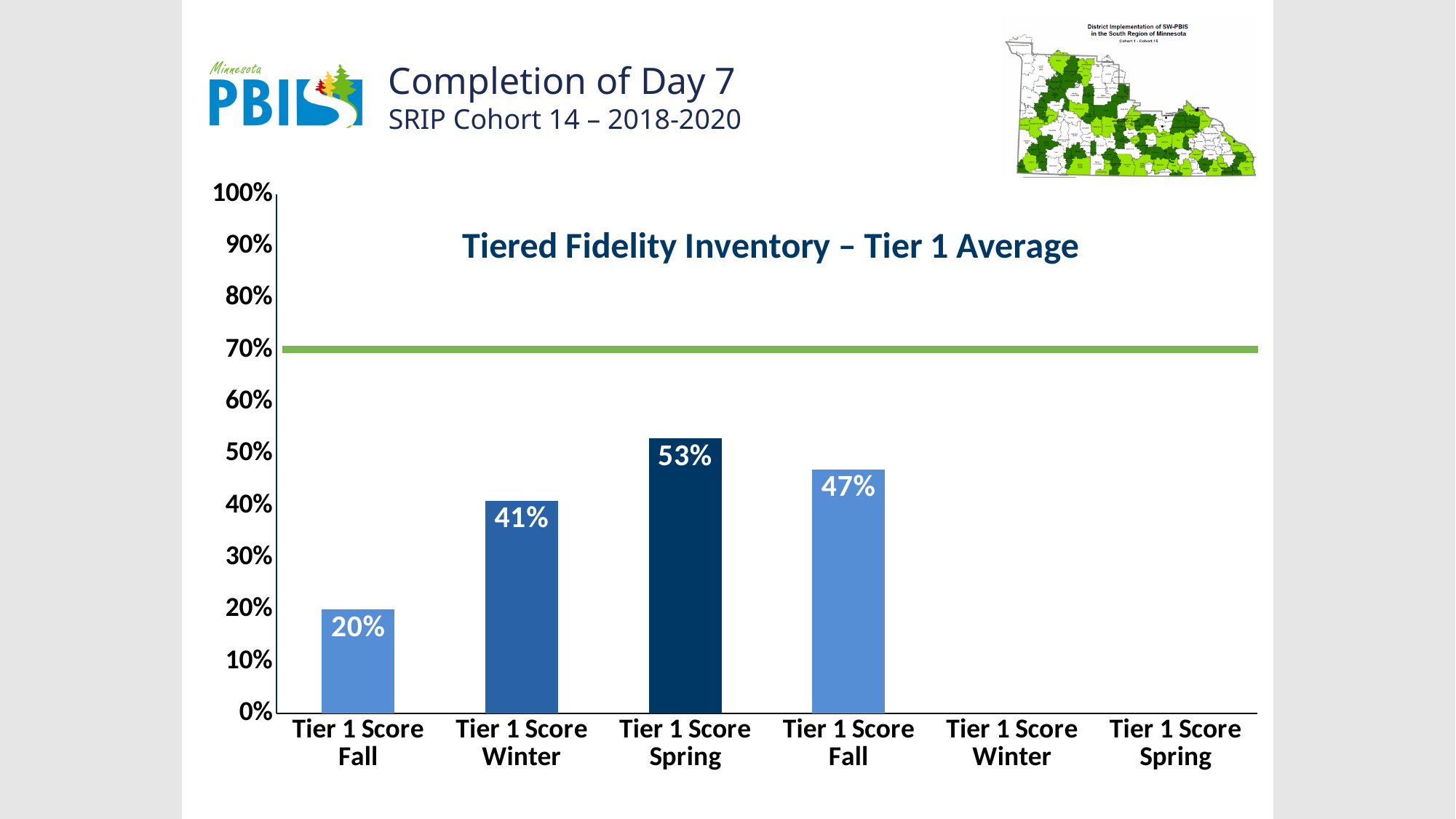
How many category labels are shown on the x axis? 6 Which bar has the highest value? Tier 1 Score Spring What is the difference between the Tier 1 Score Spring bar and the Tier 1 Score Winter bar? 12% What is the value of the second Tier 1 Score Fall bar? 47% Which bar has the lowest value? Tier 1 Score Fall (first) What is the value of the first Tier 1 Score Fall bar? 20% What is the value of the Tier 1 Score Spring bar? 53% At what value is the horizontal green line drawn? 70% What kind of chart is shown on the slide? Bar chart What is the difference between the second Tier 1 Score Fall bar and the first Tier 1 Score Fall bar? 27% What is the value of the Tier 1 Score Winter bar? 41% Which is larger, the Tier 1 Score Winter bar or the second Tier 1 Score Fall bar? Tier 1 Score Fall (second)